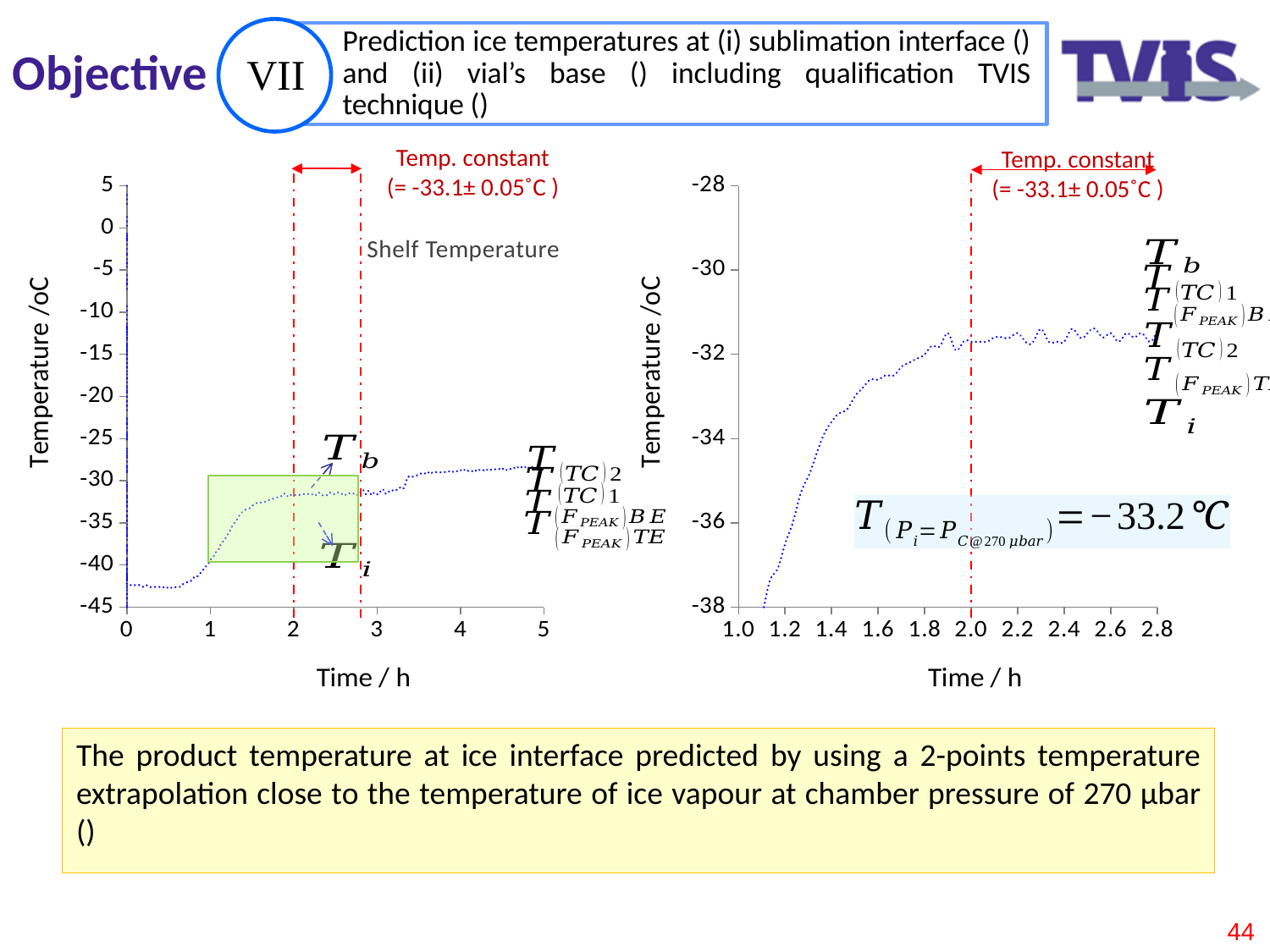
In the right chart, do the plotted temperature values rise or fall as time increases from 1.0 to 2.8 h? rise What kind of chart is the left chart on the slide? line chart In the left chart, do the plotted temperature values rise or fall as time increases from 0 to 5 h? rise In the right chart, is the temperature at time 2.4 h greater or less than -34? greater In the left chart, is the temperature at time 2 h greater or less than -35? greater In the right chart, is the temperature at time 1.2 h greater or less than -36? less What is the label of the x axis on the left chart? Time / h What constant temperature value is annotated in red above the charts? -33.1± 0.05˚C What kind of chart is the right chart on the slide? line chart